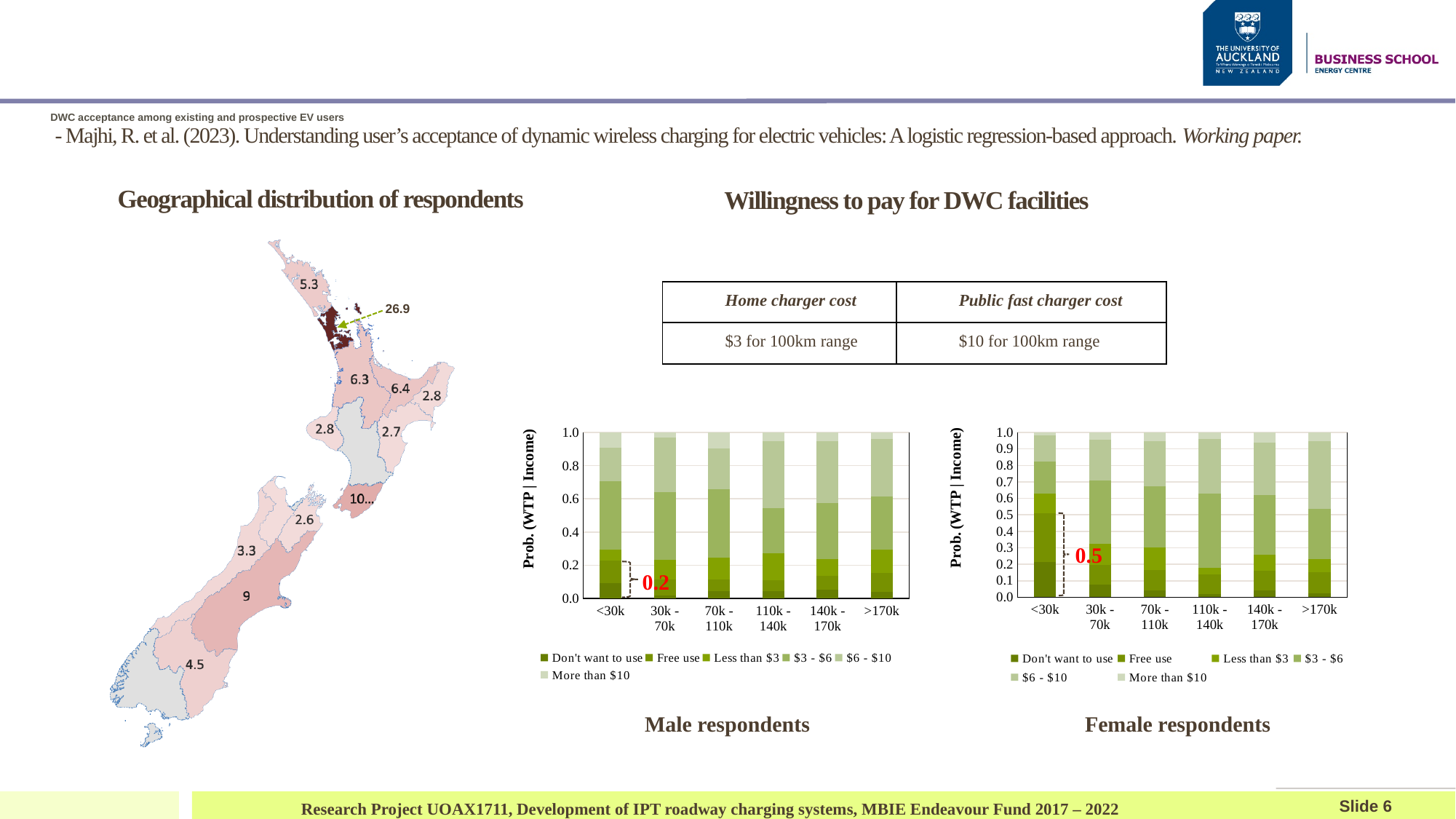
In the Female respondents chart, is the 'Don't want to use' segment larger for the <30k group or the >170k group? <30k How many series does the legend of the Male respondents chart list? 6 What annotated value is marked next to the <30k bar in the Male respondents chart? 0.2 In the Female respondents chart, does the 'Don't want to use' segment generally rise or fall as income increases along the x axis? fall In the Female respondents chart, for the 140k - 170k income group, is the cumulative probability up to and including the '$3 - $6' category greater or less than 0.5? greater In the Female respondents chart, is the 'Don't want to use' segment for the <30k income group greater or less than 0.1? greater In the Female respondents chart, which income group has the largest 'Don't want to use' segment? <30k In the Male respondents chart, for the <30k income group, is the cumulative probability up to and including the '$3 - $6' category greater or less than 0.6? greater What kind of chart is the Male respondents chart? Stacked bar chart What is the y-axis label of the Female respondents chart? Prob. (WTP | Income) On the map of the geographical distribution of respondents, what value is shown for the region indicated by the arrow? 26.9 How many income groups are shown on the x axis of the Female respondents chart? 6